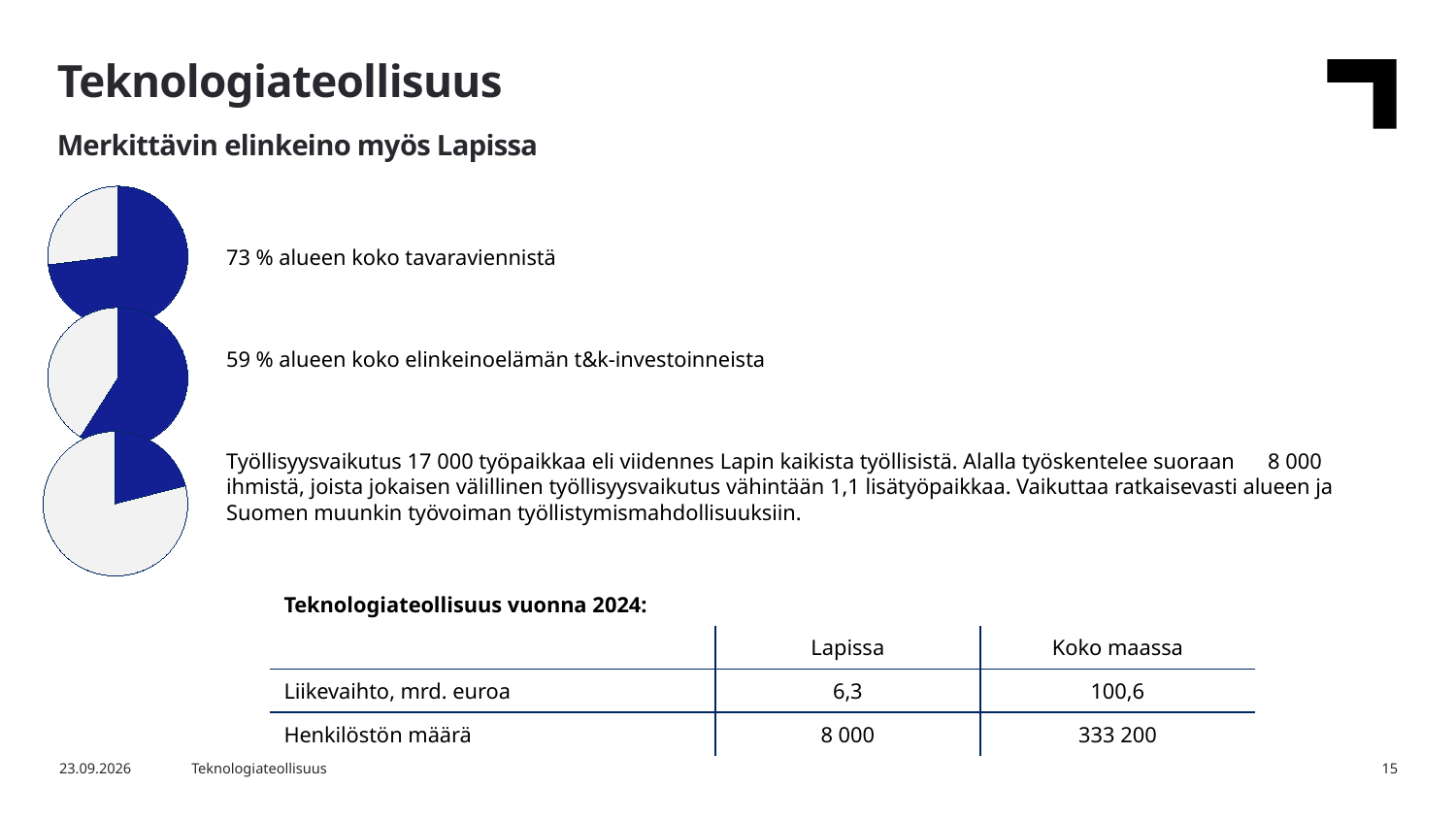
Which of the three pie charts has the largest blue slice? The top one (73 % alueen koko tavaraviennistä) In the top pie chart (alueen koko tavaraviennistä), what share does the blue slice represent? 73 % How many pie charts are shown on the slide? 3 What colour is the highlighted slice in each of the pie charts? Dark blue What does the top pie chart represent according to the text next to it? 73 % alueen koko tavaraviennistä Which has the larger blue slice: the top pie chart (tavaravienti) or the middle pie chart (t&k-investoinnit)? The top pie chart (73 %) In the bottom pie chart (työllisyysvaikutus), is the blue slice greater or less than 50 %? less In the middle pie chart (alueen koko elinkeinoelämän t&k-investoinneista), what share does the blue slice represent? 59 % In the top pie chart (tavaravienti), is the blue slice greater or less than 50 %? greater Which of the three pie charts has the smallest blue slice? The bottom one (työllisyysvaikutus) What is the difference in percentage points between the blue share of the top pie chart (73 %) and the middle pie chart (59 %)? 14 percentage points What kind of chart are the three graphics on the left side of the slide? Pie charts